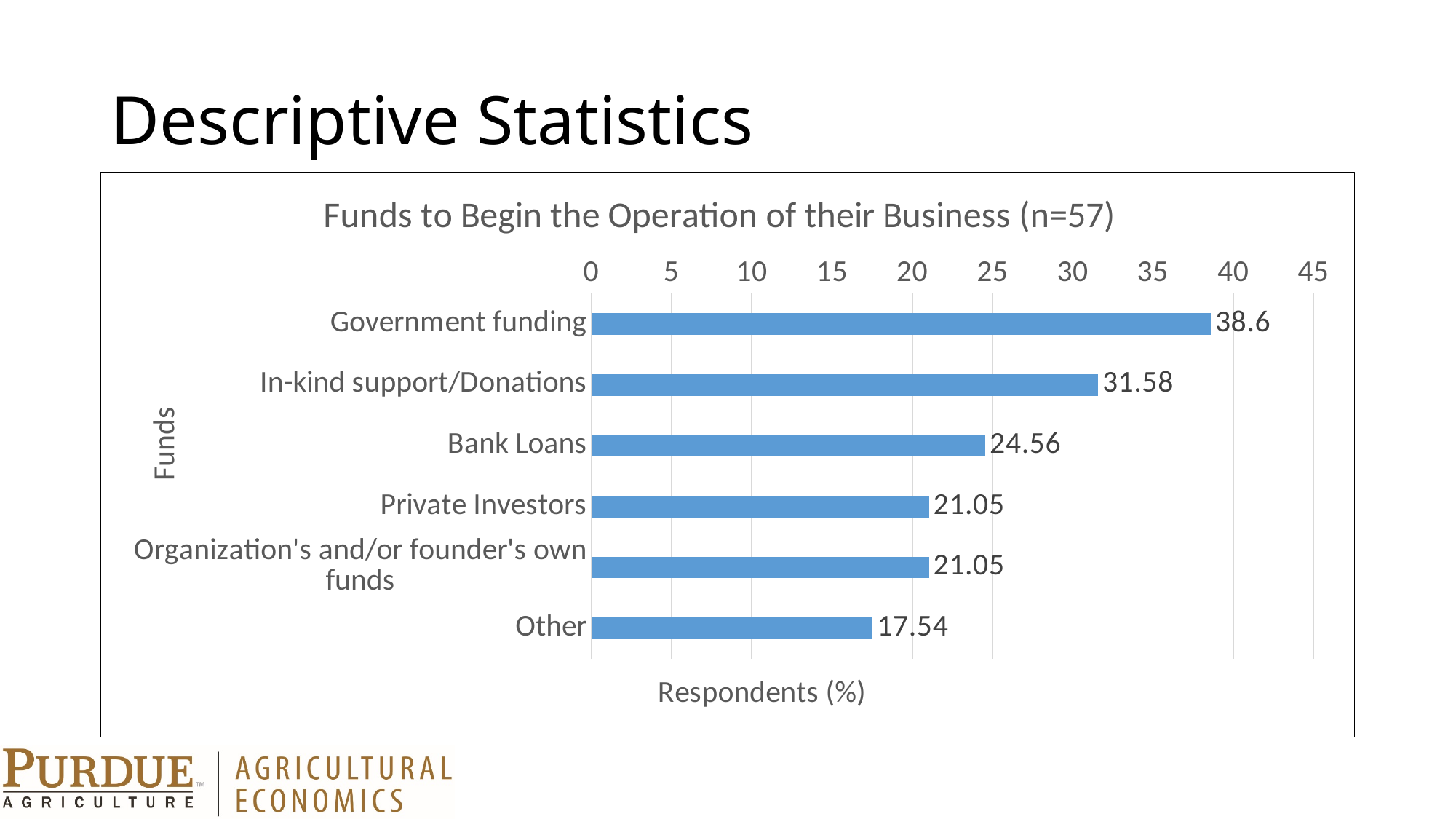
What is the title of the chart? Funds to Begin the Operation of their Business (n=57) What is the value for Government funding? 38.6 What is the difference between the values for Bank Loans and Other? 7.02 Which category has the highest value? Government funding What is the difference between the values for Government funding and In-kind support/Donations? 7.02 What is the value for Other? 17.54 Which is larger, the value for Bank Loans or the value for Private Investors? Bank Loans How many categories are shown in the chart? 6 Which category has the lowest value? Other What kind of chart is shown on the slide? Bar chart What is the value for In-kind support/Donations? 31.58 What is the value for Bank Loans? 24.56